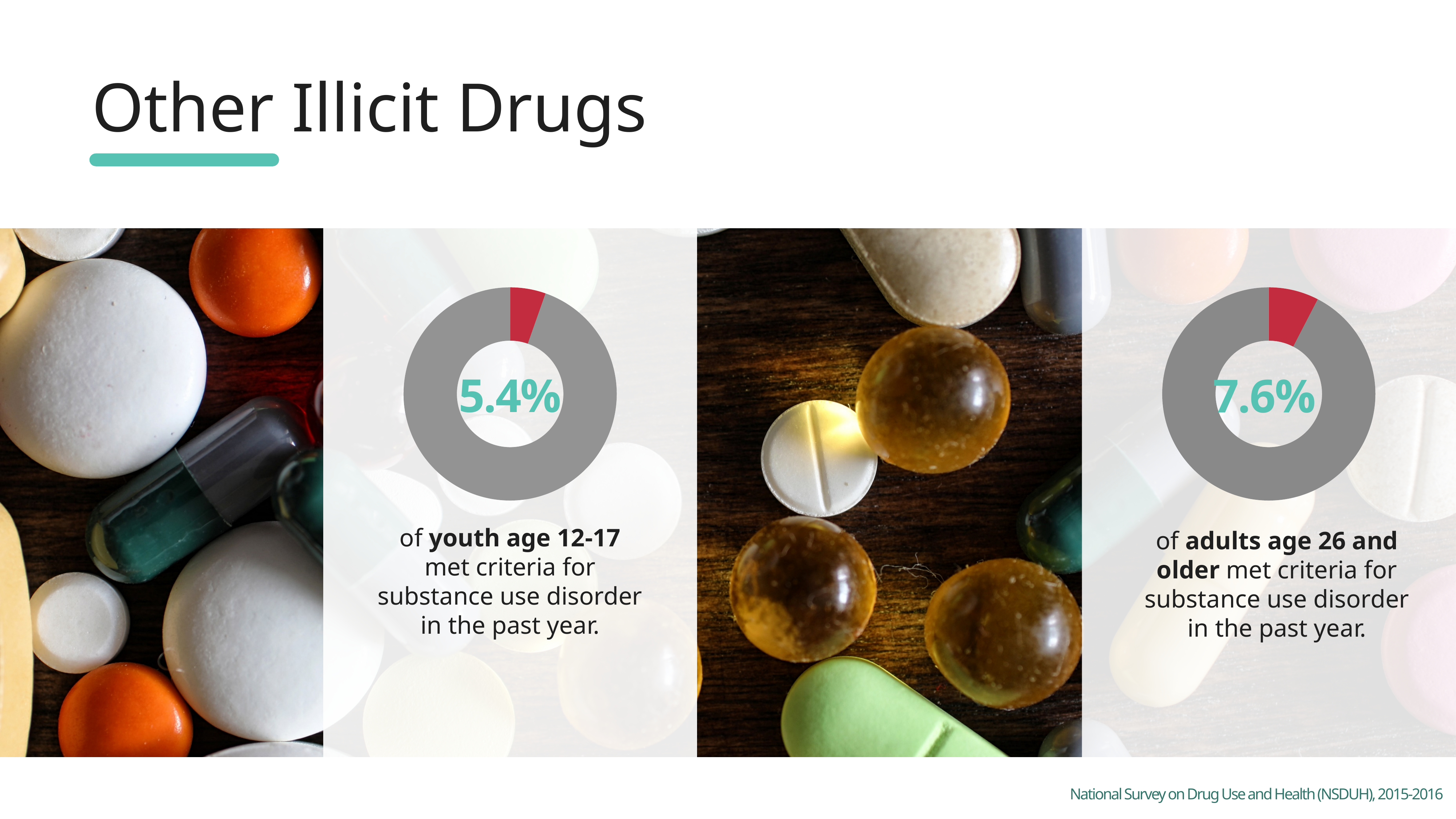
On the right donut chart, is the value for adults age 26 and older greater or less than 5%? greater On the left donut chart, what percentage of youth age 12-17 met criteria for substance use disorder in the past year? 5.4% Which group has the higher percentage meeting criteria for substance use disorder: youth age 12-17 or adults age 26 and older? adults age 26 and older What is the title of the slide containing the two donut charts? Other Illicit Drugs On the left donut chart, is the value for youth age 12-17 greater or less than 10%? less On the right donut chart, what percentage of adults age 26 and older met criteria for substance use disorder in the past year? 7.6% What is the difference between the percentage for adults age 26 and older and the percentage for youth age 12-17? 2.2% What kind of chart is used on the left to show the 5.4% figure? donut chart How many donut charts are shown on the slide? 2 What kind of chart is used on the right to show the 7.6% figure? donut chart On the left donut chart, what colour is the slice representing the 5.4% share? red